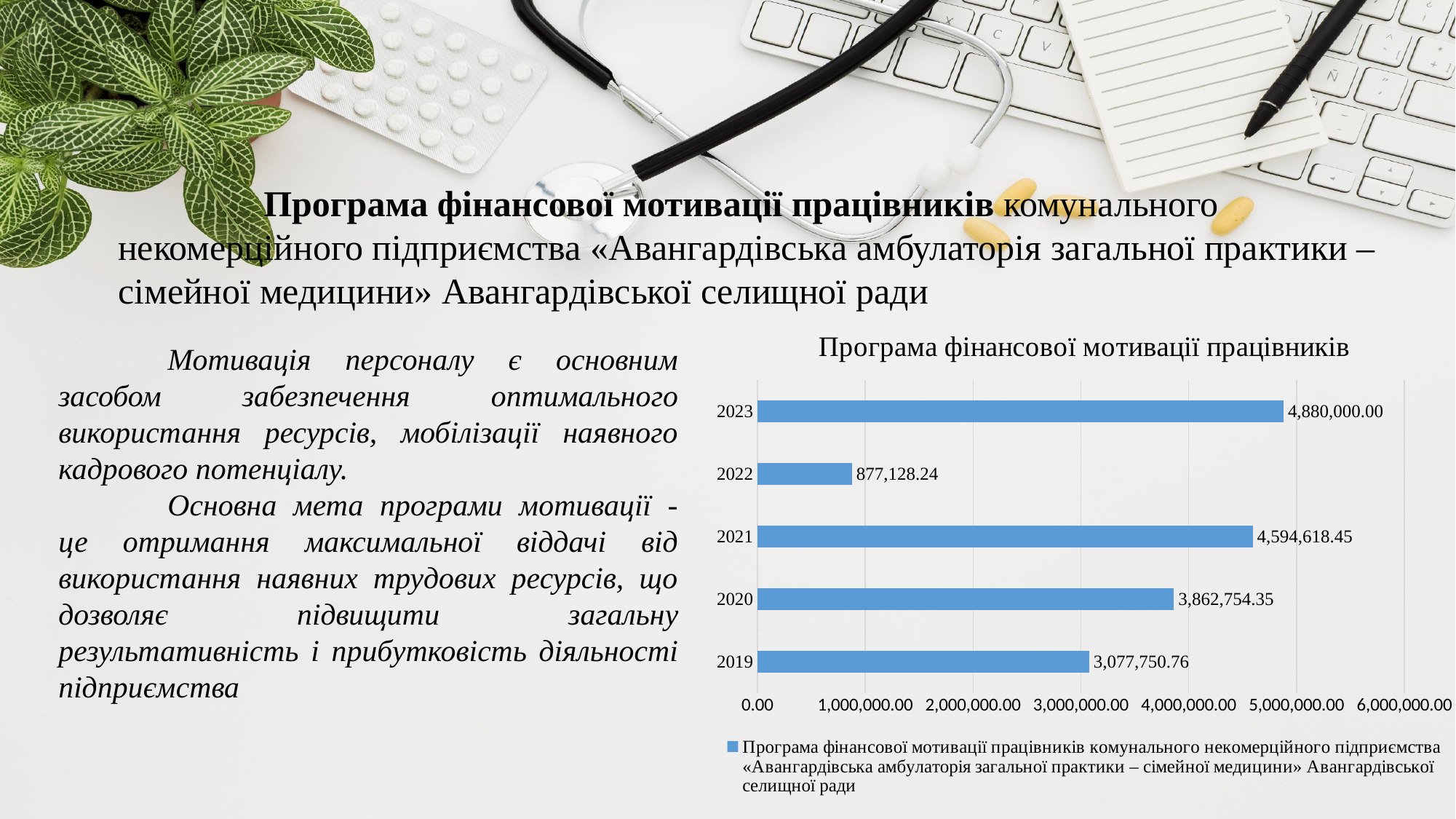
Which is larger, the value for 2021 or the value for 2020? 2021 What is the value for 2023? 4,880,000.00 What is the difference between the values for 2023 and 2022? 4,002,871.76 Which year has the lowest value? 2022 What is the value for 2019? 3,077,750.76 How many years are shown in the chart? 5 Which year has the highest value? 2023 Is the value for 2022 greater or less than 1,000,000.00? less What is the difference between the values for 2021 and 2020? 731,864.10 What is the value for 2022? 877,128.24 What kind of chart is shown on the slide? bar chart Did the value rise or fall from 2021 to 2022? fall